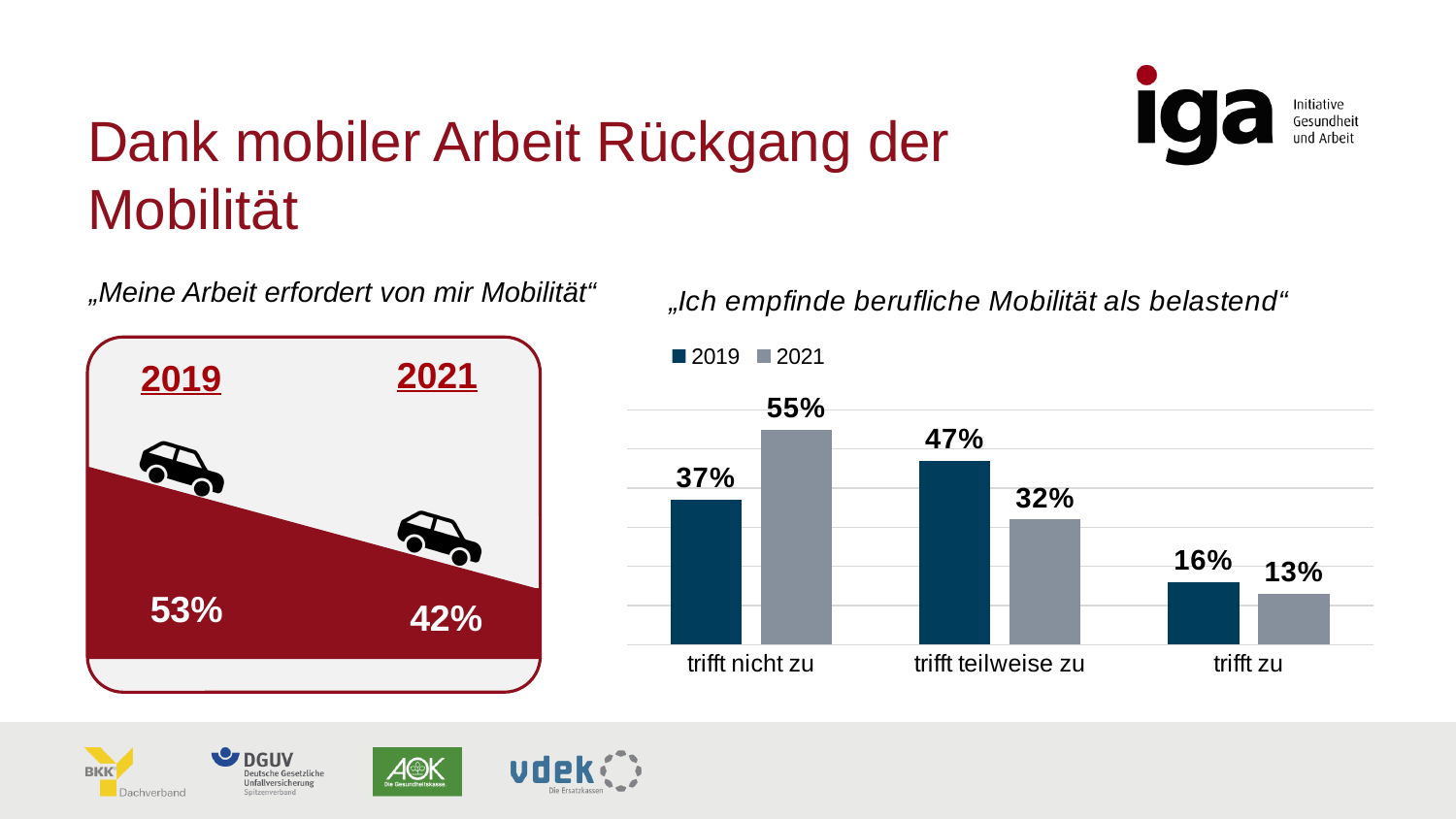
In the chart "Ich empfinde berufliche Mobilität als belastend", what is the 2021 value for "trifft zu"? 13% What kind of chart is "Ich empfinde berufliche Mobilität als belastend"? bar chart In the graphic "Meine Arbeit erfordert von mir Mobilität" on the left, what is the value shown for 2021? 42% In the chart "Ich empfinde berufliche Mobilität als belastend", which category has the highest 2021 value? trifft nicht zu In the chart "Ich empfinde berufliche Mobilität als belastend", what is the 2021 value for "trifft nicht zu"? 55% In the chart "Ich empfinde berufliche Mobilität als belastend", what is the 2019 value for "trifft nicht zu"? 37% In the chart "Ich empfinde berufliche Mobilität als belastend", what is the 2019 value for "trifft teilweise zu"? 47% In the chart "Ich empfinde berufliche Mobilität als belastend", which category has the lowest 2019 value? trifft zu How many categories are shown on the x axis of the chart "Ich empfinde berufliche Mobilität als belastend"? 3 How many series does the legend of the chart "Ich empfinde berufliche Mobilität als belastend" list? 2 In the chart "Ich empfinde berufliche Mobilität als belastend", which is larger for "trifft teilweise zu": the 2019 value or the 2021 value? 2019 In the chart "Ich empfinde berufliche Mobilität als belastend", what is the difference between the 2021 and 2019 values for "trifft nicht zu"? 18%